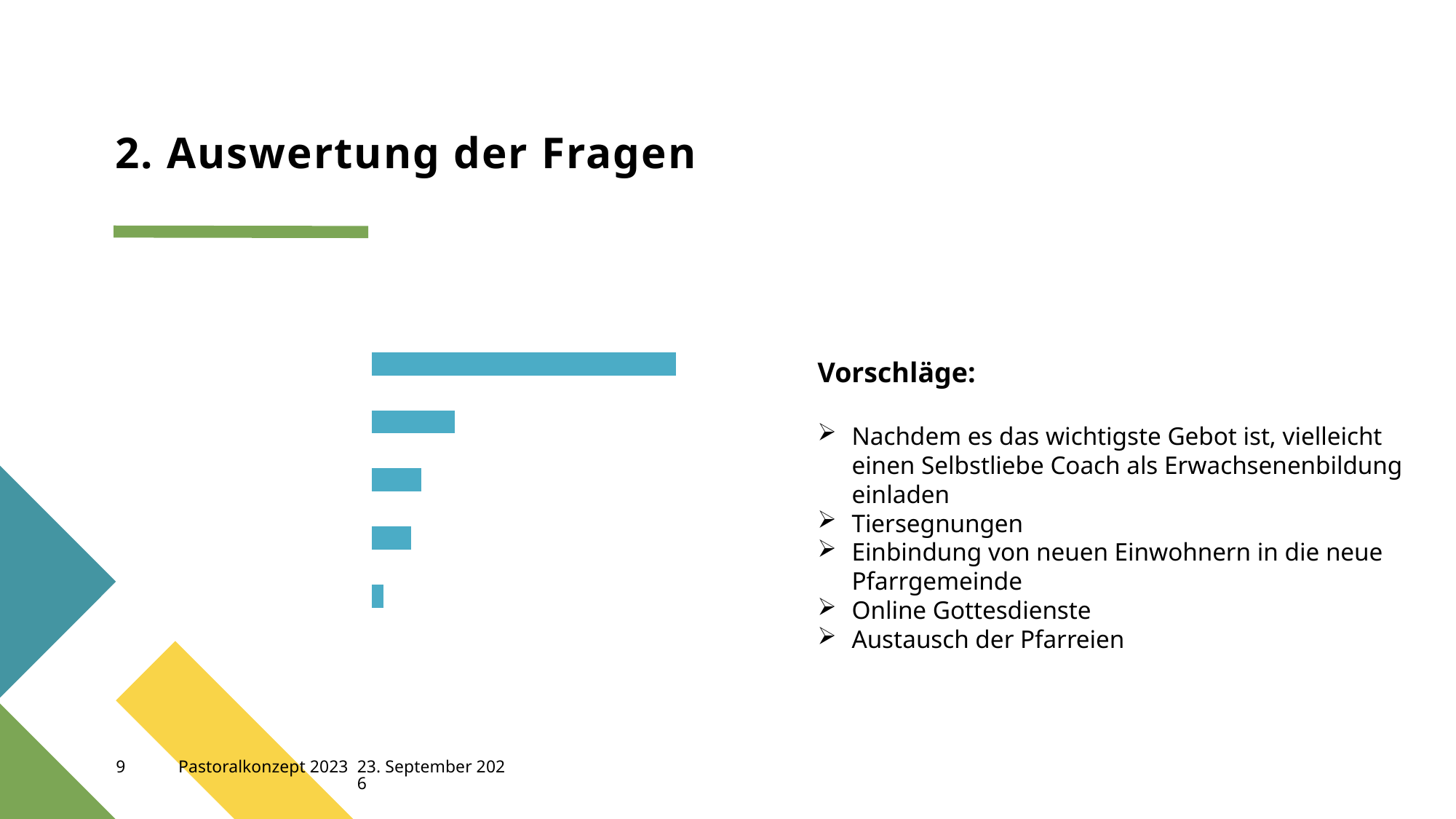
Is the fourth bar from the top longer or shorter than the bottom bar? longer Which bar in the chart is the shortest? the bottom bar Is the top bar in the chart longer or shorter than the second bar from the top? longer Do the bar lengths increase or decrease going from the top bar to the bottom bar? decrease Which bar in the chart is the longest: the top one or the bottom one? the top one What kind of chart is shown on the slide? bar chart How many bars does the chart on the slide contain? 5 What colour are the bars in the chart? blue Are the bars in the chart oriented horizontally or vertically? horizontally